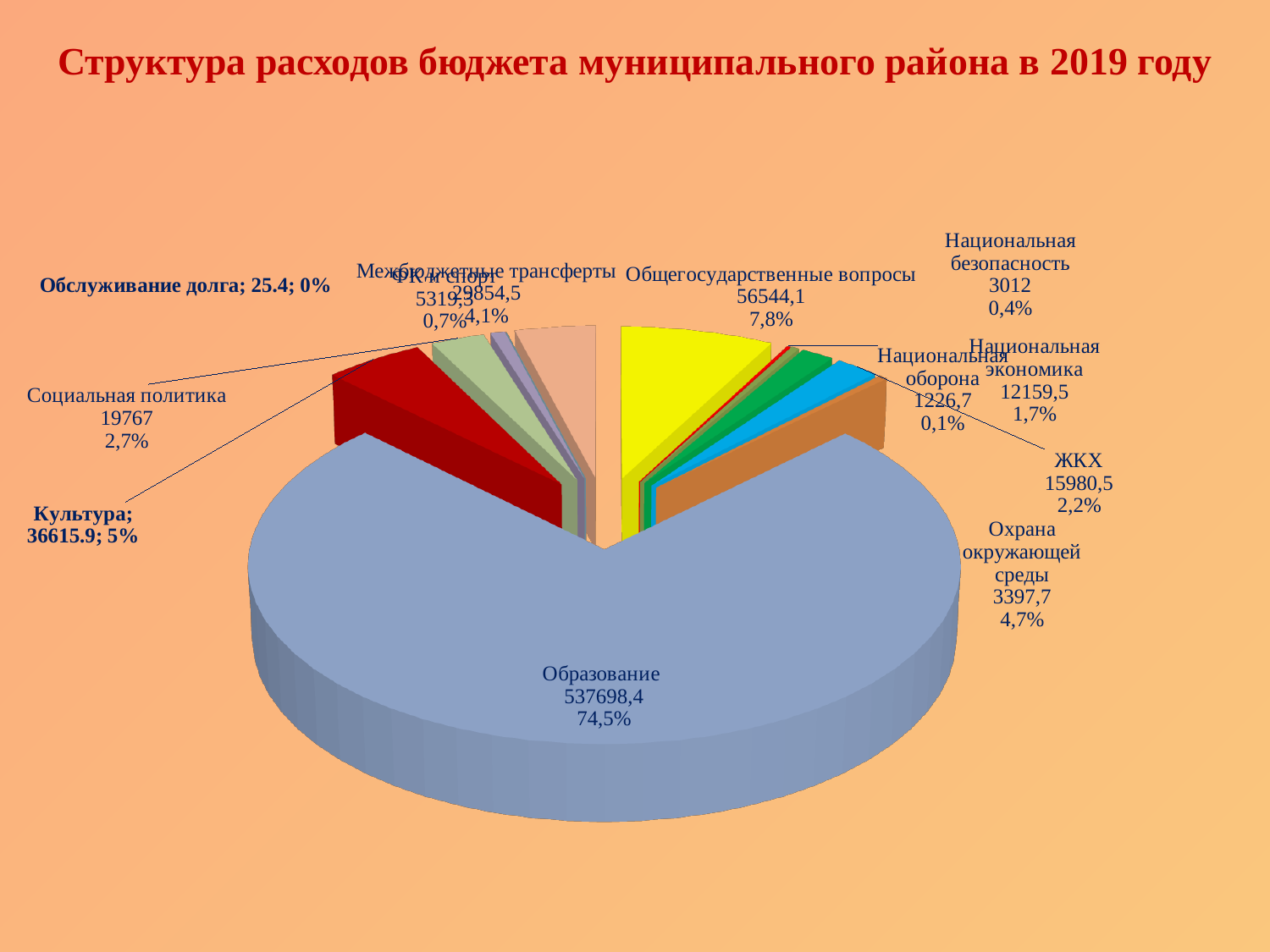
What kind of chart is shown on the slide? pie chart Which category has the largest slice of the pie? Образование What share of the pie does Образование take? 74,5% Which is larger, ЖКХ or Национальная экономика? ЖКХ What share of the pie does Культура take? 5% What is the value shown for Социальная политика? 19767 What is the value shown for Образование? 537698,4 What is the value shown for ЖКХ? 15980,5 What is the title of the chart? Структура расходов бюджета муниципального района в 2019 году What is the value shown for Общегосударственные вопросы? 56544,1 Which category has the smallest value? Обслуживание долга What is the difference between the values for ЖКХ and Национальная экономика? 3821